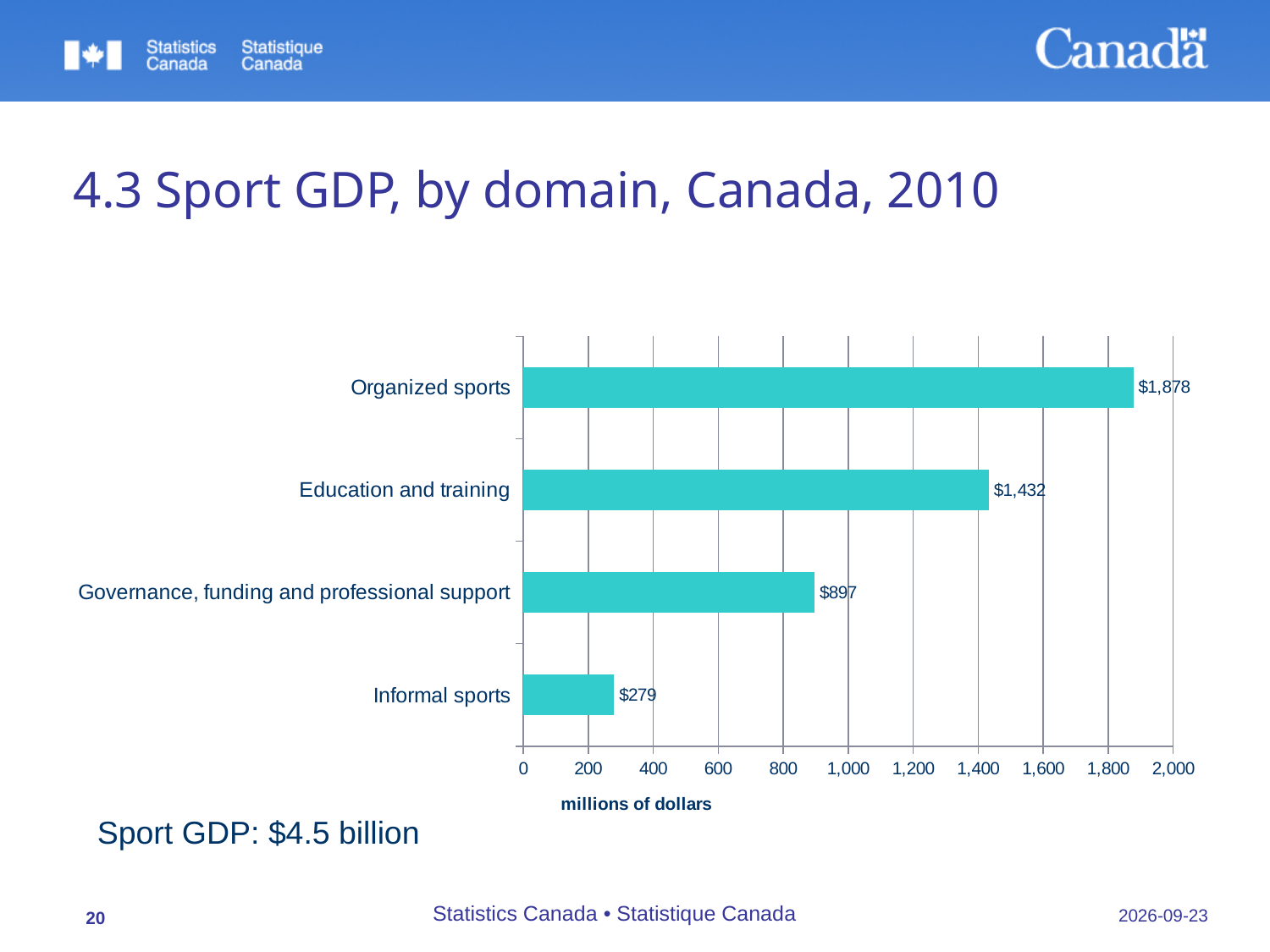
What is the sport GDP value for Organized sports? $1,878 What is the sport GDP value for Governance, funding and professional support? $897 Which domain has the lowest sport GDP? Informal sports Which domain has the highest sport GDP? Organized sports What is the sport GDP value for Education and training? $1,432 What kind of chart is shown on the slide? Bar chart What unit is shown on the x axis of the chart? millions of dollars Which has a larger sport GDP, Education and training or Governance, funding and professional support? Education and training What is the sport GDP value for Informal sports? $279 What is the difference between the sport GDP of Organized sports and Education and training? $446 What is the difference between the sport GDP of Governance, funding and professional support and Informal sports? $618 How many domains are shown in the chart? 4